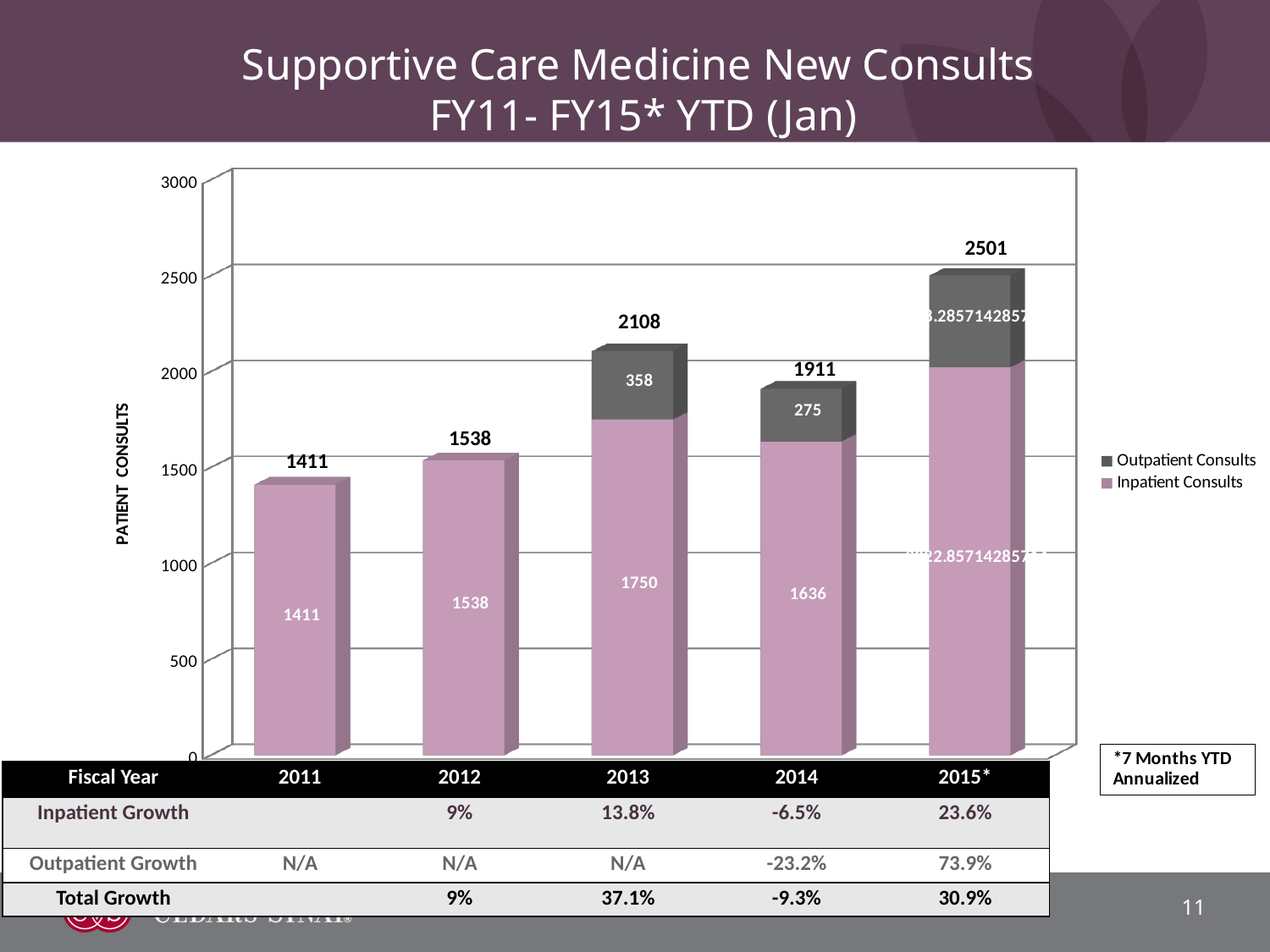
What is the difference between Outpatient Consults in 2013 and in 2014? 83 Which fiscal year has the lowest total patient consults? 2011 What is the total number of patient consults for 2015*? 2501 Which year has more Inpatient Consults, 2013 or 2014? 2013 How many fiscal years are plotted on the x axis of the chart? 5 How many series does the chart legend list? 2 What is the difference between the total consults in 2013 and in 2014? 197 What is the label on the vertical axis of the chart? PATIENT CONSULTS What kind of chart is shown on the slide? bar chart What is the value of Outpatient Consults for 2014? 275 Which fiscal year has the highest total patient consults? 2015* What is the value of Inpatient Consults for 2013? 1750